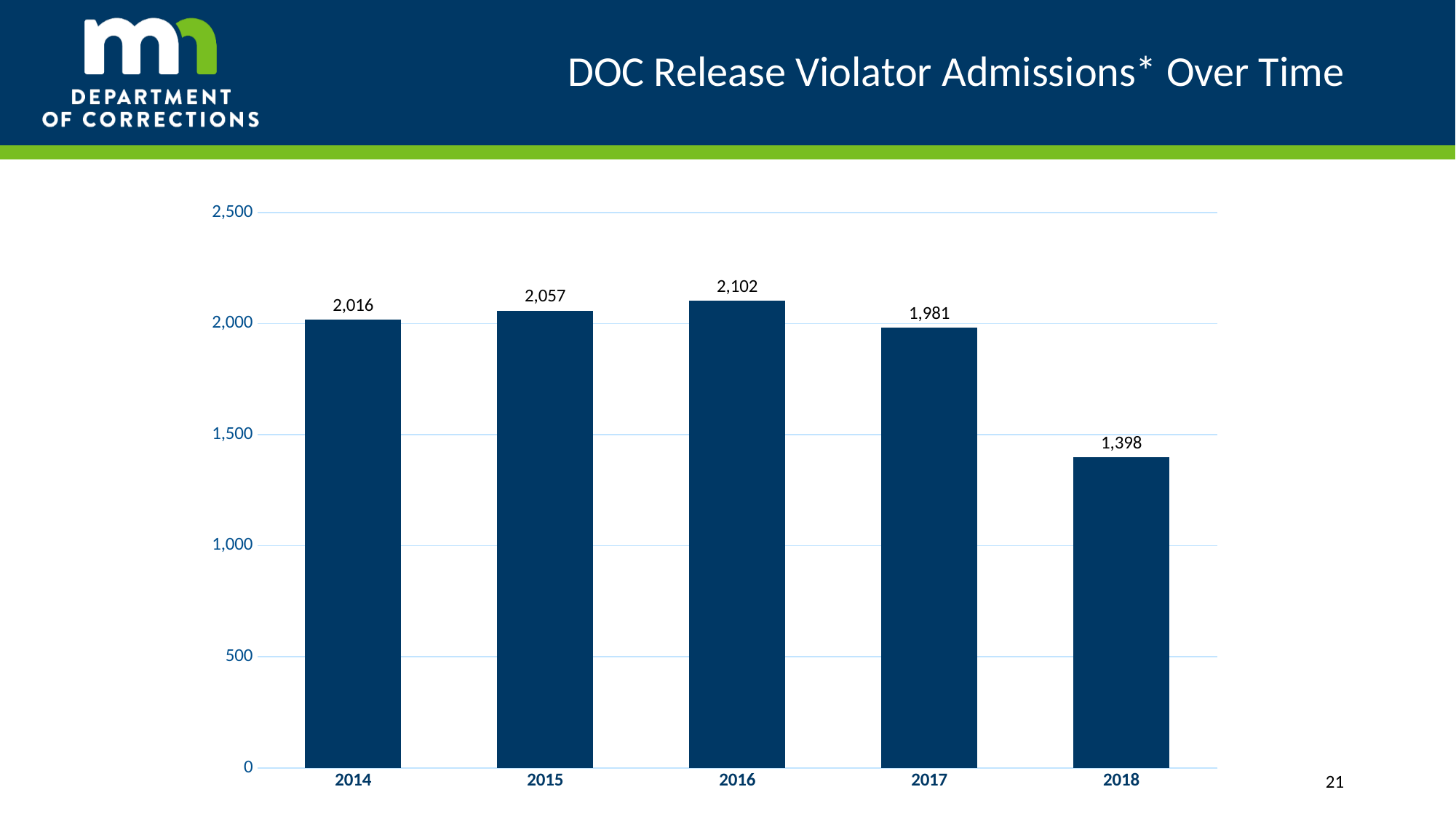
Is the value for 2018 greater or less than 1,500? less What is the difference between the values for 2017 and 2018? 583 Which is larger, the value for 2015 or the value for 2017? 2015 What kind of chart is shown on the slide? bar chart What is the value for 2014? 2,016 What is the title of the chart? DOC Release Violator Admissions* Over Time What is the value for 2018? 1,398 Which year has the lowest value? 2018 What is the difference between the values for 2016 and 2015? 45 Which year has the highest value? 2016 What is the value for 2016? 2,102 How many years are shown on the x axis? 5